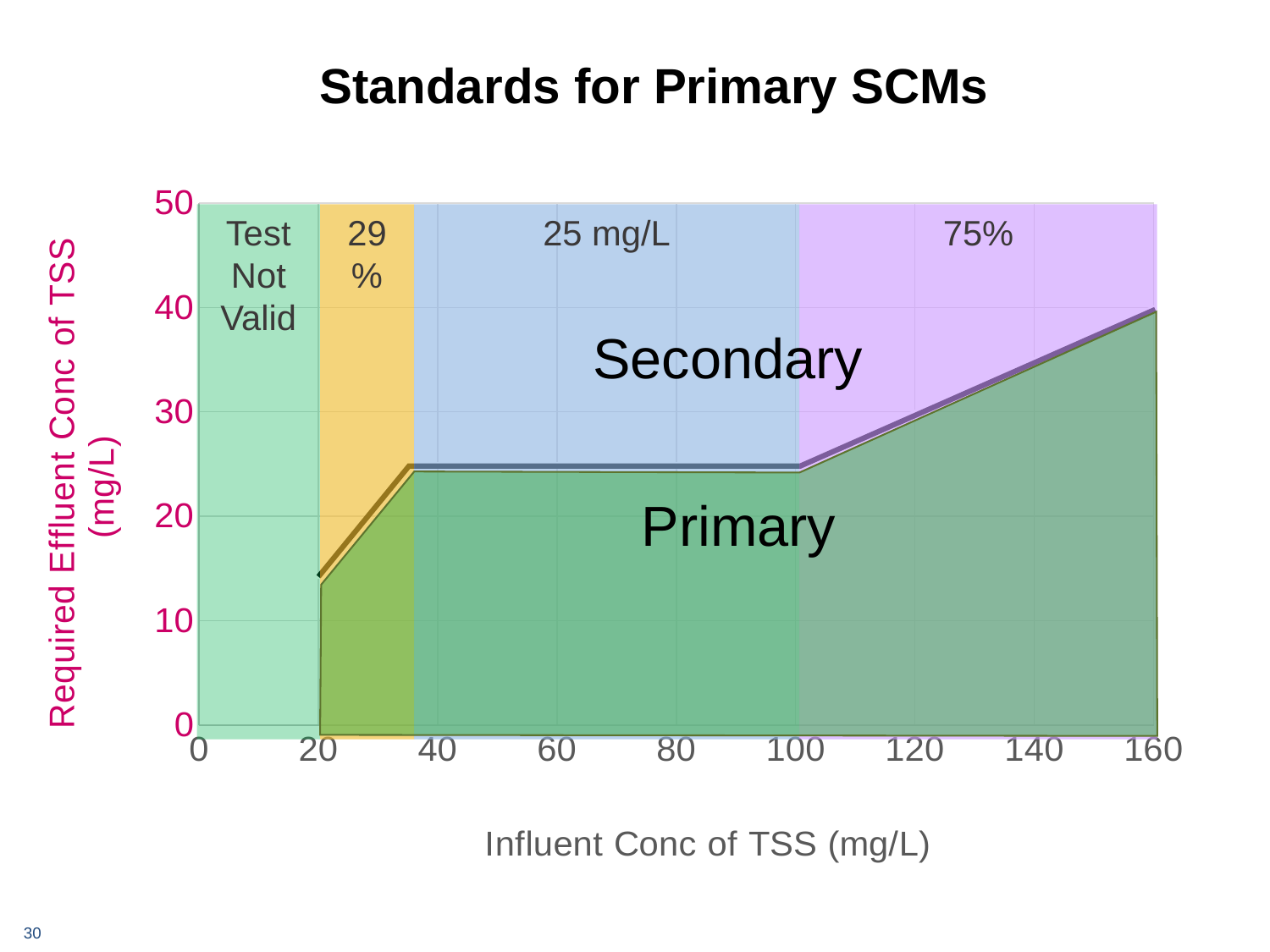
Does the required effluent concentration rise, fall, or stay flat as influent concentration increases from 40 to 100 mg/L? stay flat Is the required effluent concentration at an influent concentration of 20 mg/L greater or less than 10? greater Is the required effluent concentration at an influent concentration of 60 mg/L greater or less than 20? greater Which is larger, the required effluent concentration at an influent concentration of 160 mg/L or at 60 mg/L? 160 mg/L What is the label of the x axis? Influent Conc of TSS (mg/L) Does the required effluent concentration rise, fall, or stay flat as influent concentration increases from 100 to 160 mg/L? rise Is the required effluent concentration at an influent concentration of 60 mg/L greater or less than 30? less What is the maximum value shown on the y axis? 50 What kind of chart is shown on the slide? area chart What is the title of the chart? Standards for Primary SCMs